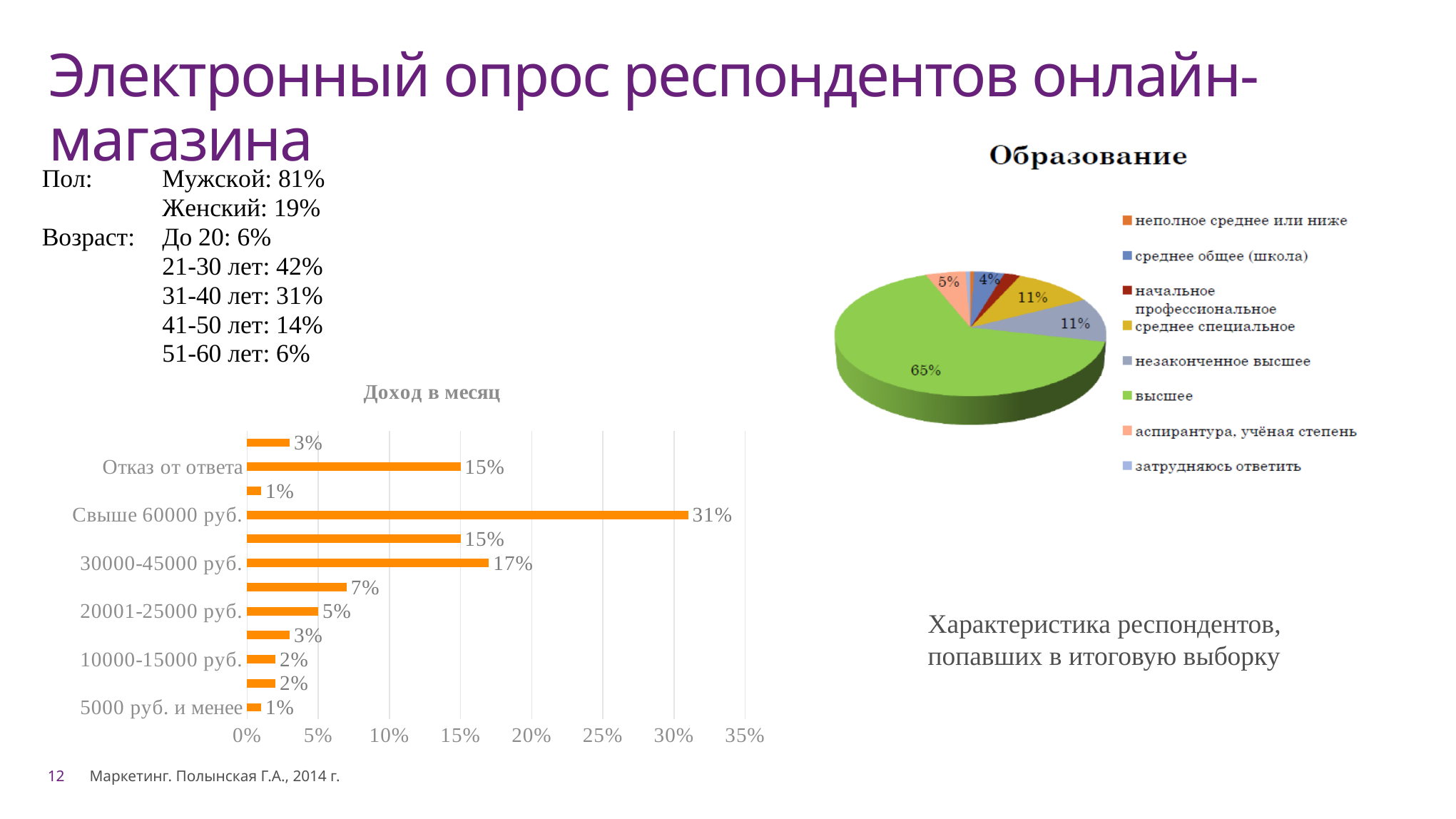
In the bar chart 'Доход в месяц', which category has the highest value? Свыше 60000 руб. In the bar chart 'Доход в месяц', what is the value for 'Отказ от ответа'? 15% In the pie chart 'Образование', which category has the largest slice? высшее What kind of chart is 'Доход в месяц'? Bar chart In the pie chart 'Образование', what share does 'высшее' have? 65% In the bar chart 'Доход в месяц', which is larger: the value for 'Отказ от ответа' or for '30000-45000 руб.'? 30000-45000 руб. How many bars are plotted in the bar chart 'Доход в месяц'? 12 In the bar chart 'Доход в месяц', what is the value for '5000 руб. и менее'? 1% In the bar chart 'Доход в месяц', what is the difference between the values for 'Свыше 60000 руб.' and '30000-45000 руб.'? 14% In the bar chart 'Доход в месяц', what is the value for '20001-25000 руб.'? 5% How many entries does the legend of the pie chart 'Образование' list? 8 In the bar chart 'Доход в месяц', what is the value for 'Свыше 60000 руб.'? 31%